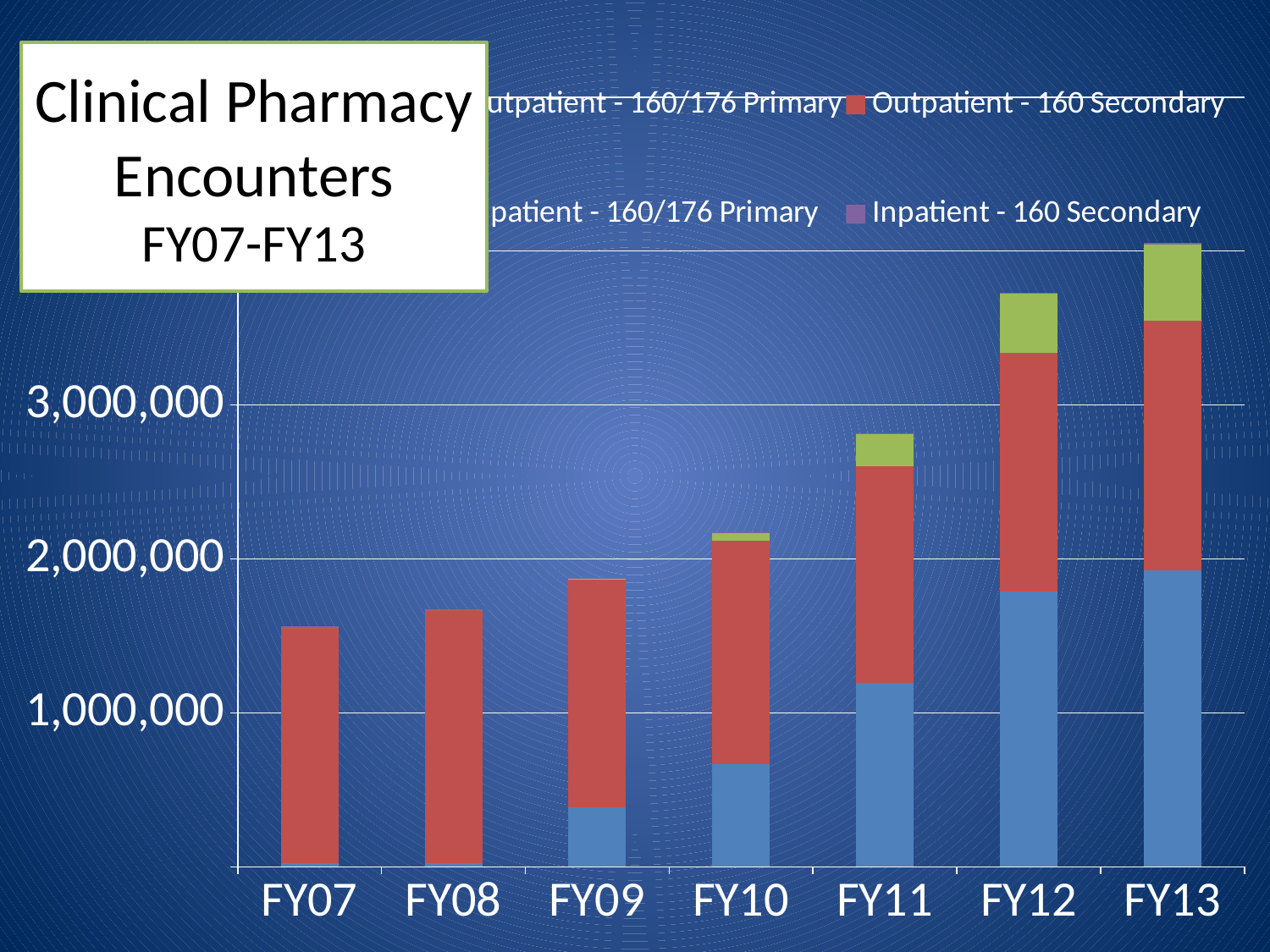
Which has the larger total, FY11 or FY12? FY12 Which fiscal year has the tallest stacked bar? FY13 What kind of chart is shown on the slide? Stacked bar chart Which fiscal year has the shortest stacked bar? FY07 What is the title of the chart? Clinical Pharmacy Encounters FY07-FY13 Do the total encounters rise or fall from FY07 to FY13? Rise Is the total for FY09 greater or less than 2,000,000? less Is the total for FY13 greater or less than 3,000,000? greater Is the total for FY07 greater or less than 2,000,000? less How many series does the chart legend list? 4 How many fiscal years are shown on the x axis of the chart? 7